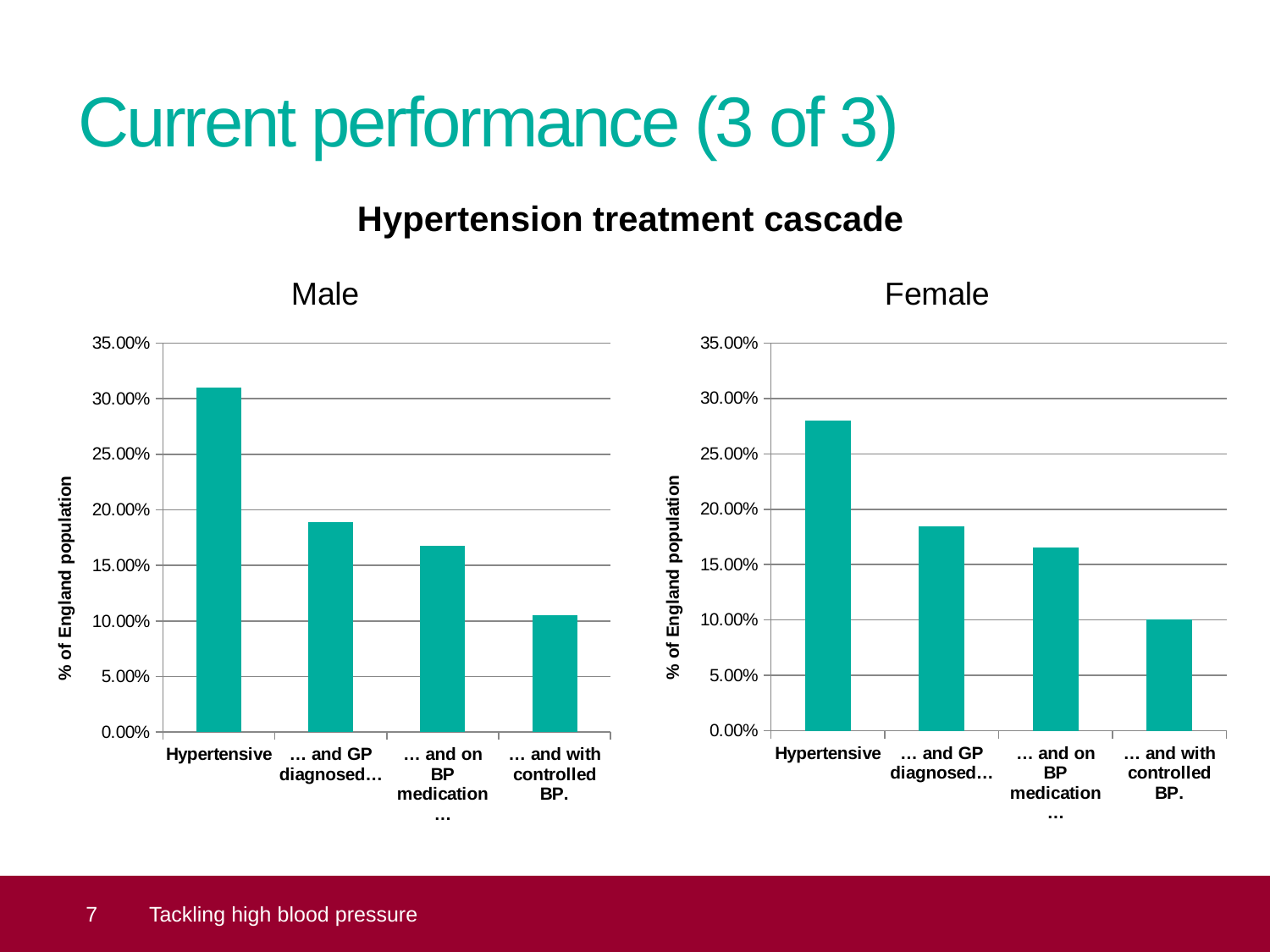
In the Female chart, is the value for Hypertensive greater or less than 30.00%? less In the Female chart, which category has the lowest value? … and with controlled BP. What type of chart is the Male chart? bar chart In the Male chart, is the value for Hypertensive greater or less than 30.00%? greater How many categories are shown in the Female chart? 4 What is the overall title shown above the two charts? Hypertension treatment cascade In the Female chart, is the value for '… and GP diagnosed…' greater or less than 20.00%? less Which is larger: the Hypertensive value in the Male chart or the Hypertensive value in the Female chart? Male In the Male chart, which category has the highest value? Hypertensive What is the y-axis label of the Female chart? % of England population In the Male chart, do the values rise or fall from left to right along the x axis? fall